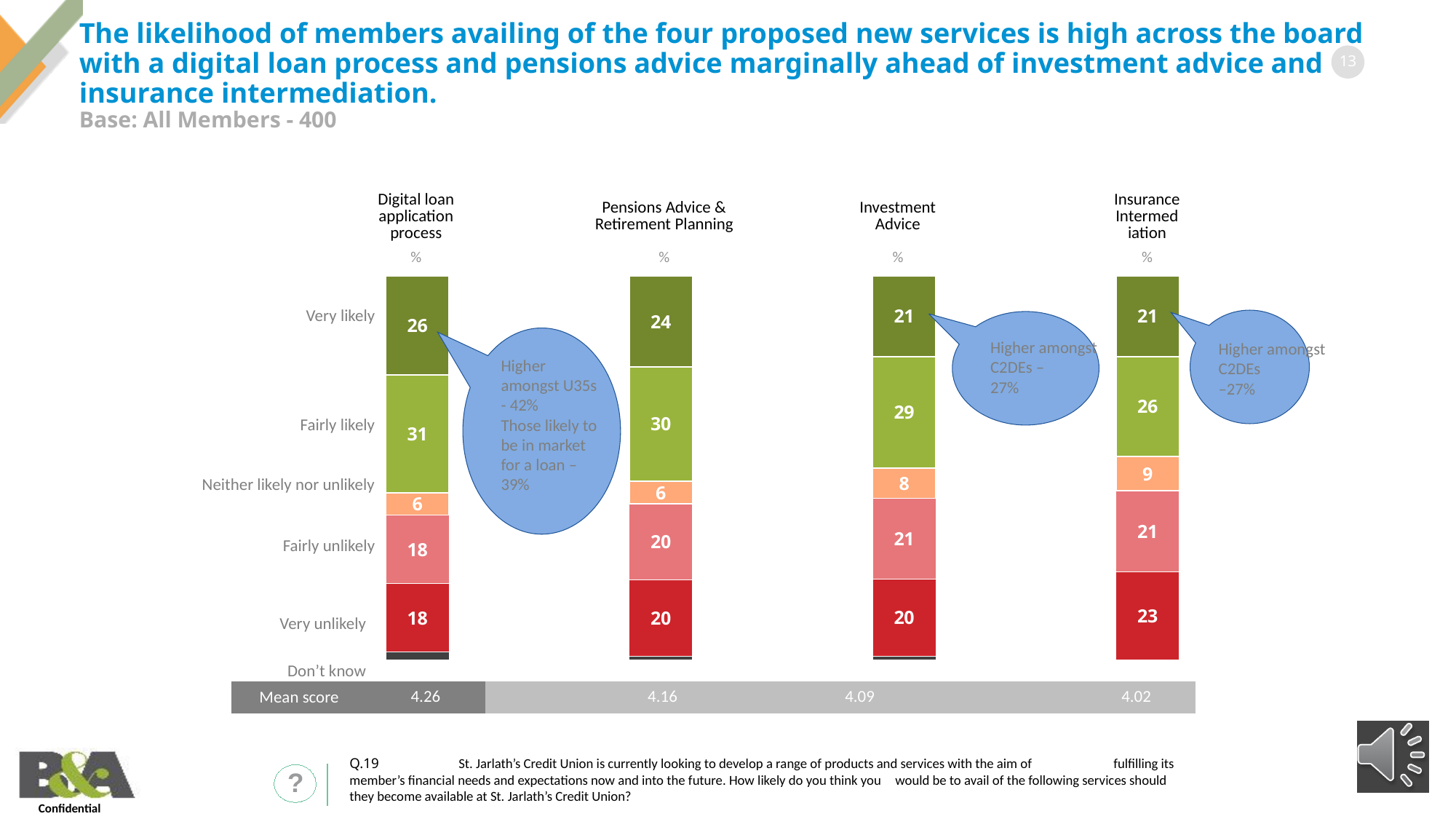
What is the 'Very unlikely' value for Insurance Intermediation? 23 Is the 'Neither likely nor unlikely' value larger for Investment Advice or for Insurance Intermediation? Insurance Intermediation Which service has the highest mean score? Digital loan application process What percentage of members are 'Very likely' to avail of the Digital loan application process? 26 How many services are shown as stacked bars in the chart? 4 What type of chart is used to show the likelihood of availing of each service? Stacked bar chart What percentage of members are 'Fairly likely' to avail of Pensions Advice & Retirement Planning? 30 Which service has the lowest mean score? Insurance Intermediation Which service has the highest 'Fairly likely' percentage? Digital loan application process What is the mean score for Investment Advice? 4.09 What is the base stated for the chart? All Members - 400 What is the difference between the 'Very likely' percentages for the Digital loan application process and Investment Advice? 5